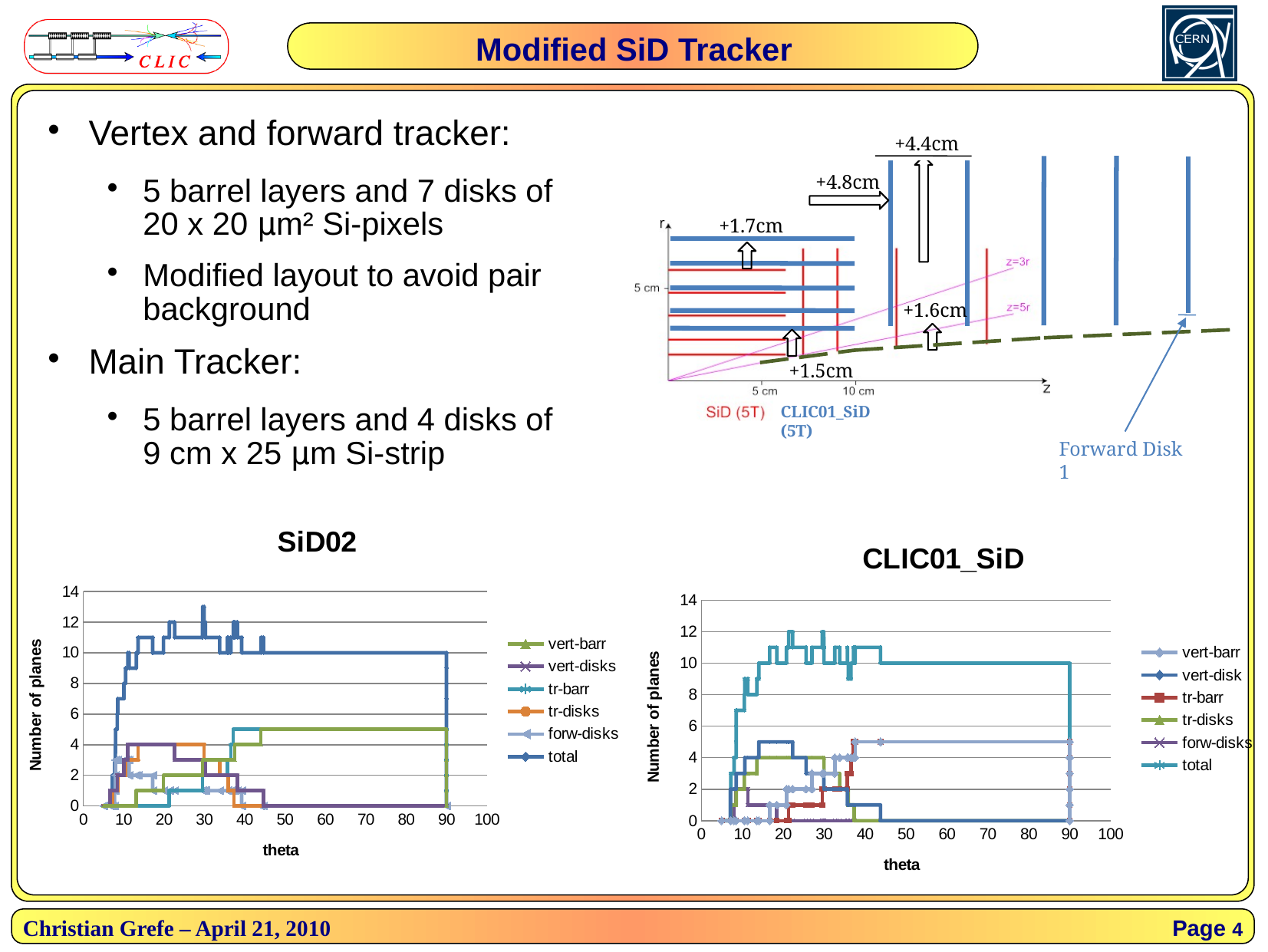
In the CLIC01_SiD chart, which series reaches the highest number of planes? total How many series does the legend of the SiD02 chart list? 6 In the SiD02 chart, is the value of the total series at theta 60 greater or less than 8? greater In the SiD02 chart, what is the value of the total series at theta 80? 10 In the CLIC01_SiD chart, is the value of the vert-barr series at theta 60 greater or less than 6? less In the SiD02 chart, which series reaches the highest number of planes? total What kind of chart is the SiD02 chart? line chart In the CLIC01_SiD chart, is the value of the total series at theta 70 greater or less than 12? less What is the y-axis label of the CLIC01_SiD chart? Number of planes How many series does the legend of the CLIC01_SiD chart list? 6 What is the x-axis label of the SiD02 chart? theta